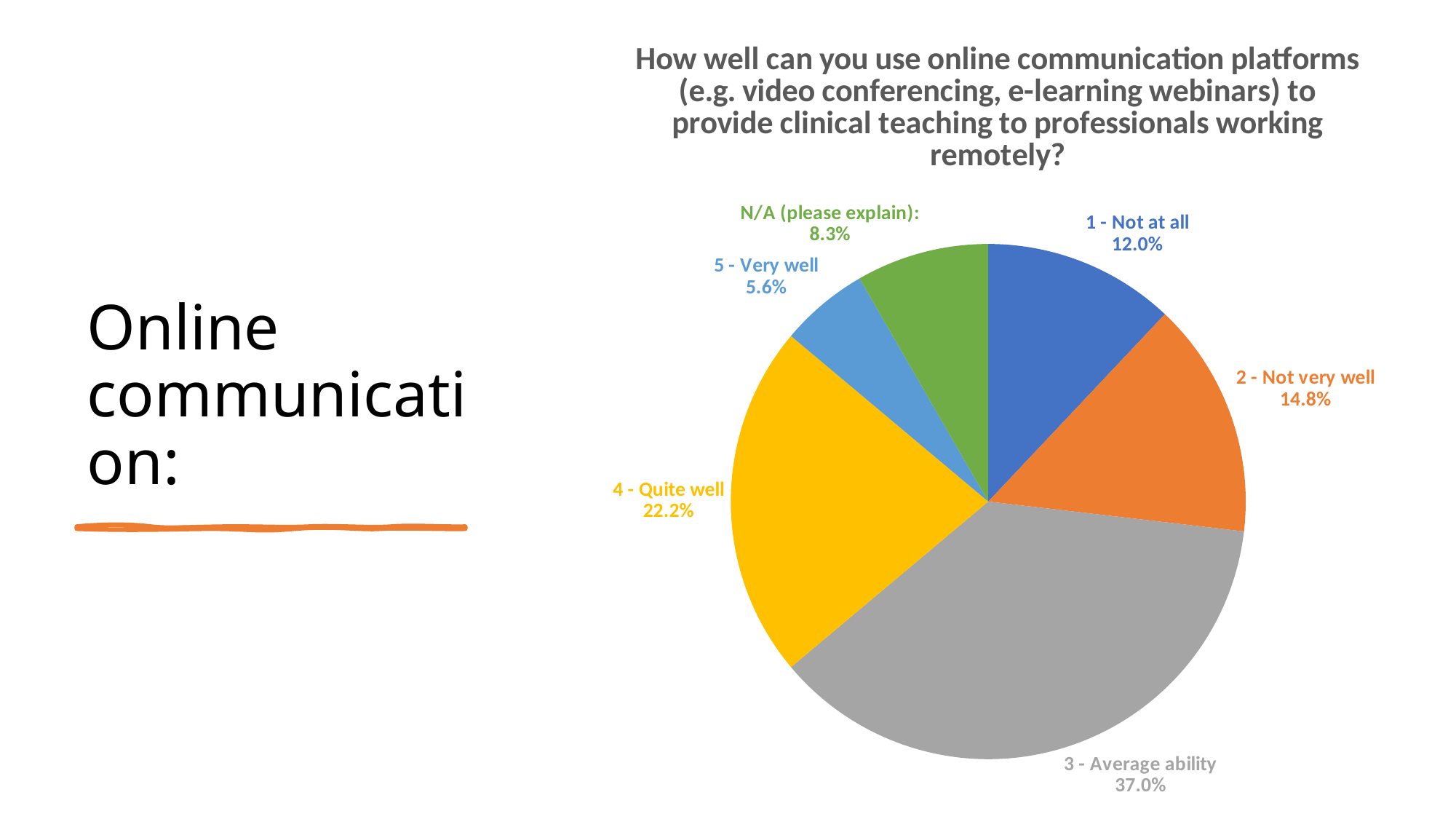
What kind of chart is shown on the slide? Pie chart Which response category has the largest share of the pie? 3 - Average ability What percentage of respondents answered "3 - Average ability"? 37.0% What percentage of respondents answered "1 - Not at all"? 12.0% Which is larger: the share for "2 - Not very well" or the share for "1 - Not at all"? 2 - Not very well What is the combined share of "4 - Quite well" and "5 - Very well"? 27.8% Which response category has the smallest share of the pie? 5 - Very well What percentage of respondents answered "N/A (please explain):"? 8.3% What percentage of respondents answered "5 - Very well"? 5.6% How many slices does the pie chart have? 6 What is the difference in percentage points between "4 - Quite well" and "2 - Not very well"? 7.4 What colour is the slice for "3 - Average ability"? Grey